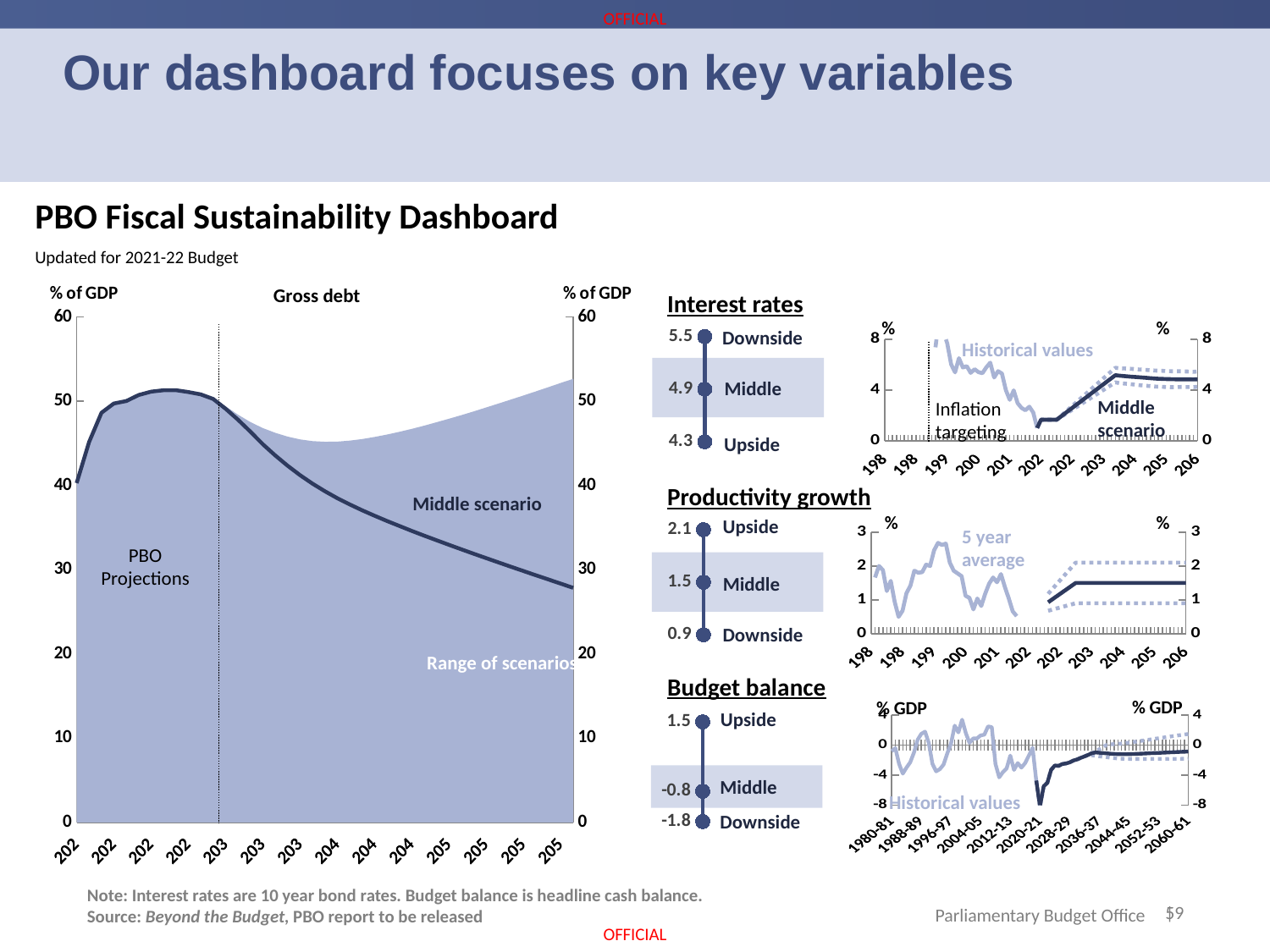
On the Productivity growth scale, what is the value for the Upside scenario? 2.1 On the Budget balance scale, which is larger, the Upside value or the Downside value? Upside In the Gross debt chart, does the Middle scenario line rise or fall after its peak near the start of the projection period? fall On the Interest rates scale, what is the value for the Downside scenario? 5.5 On the Interest rates scale, what is the difference between the Downside and Upside values? 1.2 On the Interest rates scale, what is the value for the Middle scenario? 4.9 In the Gross debt chart, is the Middle scenario value at the far right end of the projection greater or less than 30? less What is the y-axis label of the Gross debt chart? % of GDP On the Budget balance scale, what is the value for the Middle scenario? -0.8 On the Productivity growth scale, what is the difference between the Upside and Downside values? 1.2 On the Budget balance scale, what is the value for the Downside scenario? -1.8 On the Interest rates scale, which scenario has the lowest value? Upside